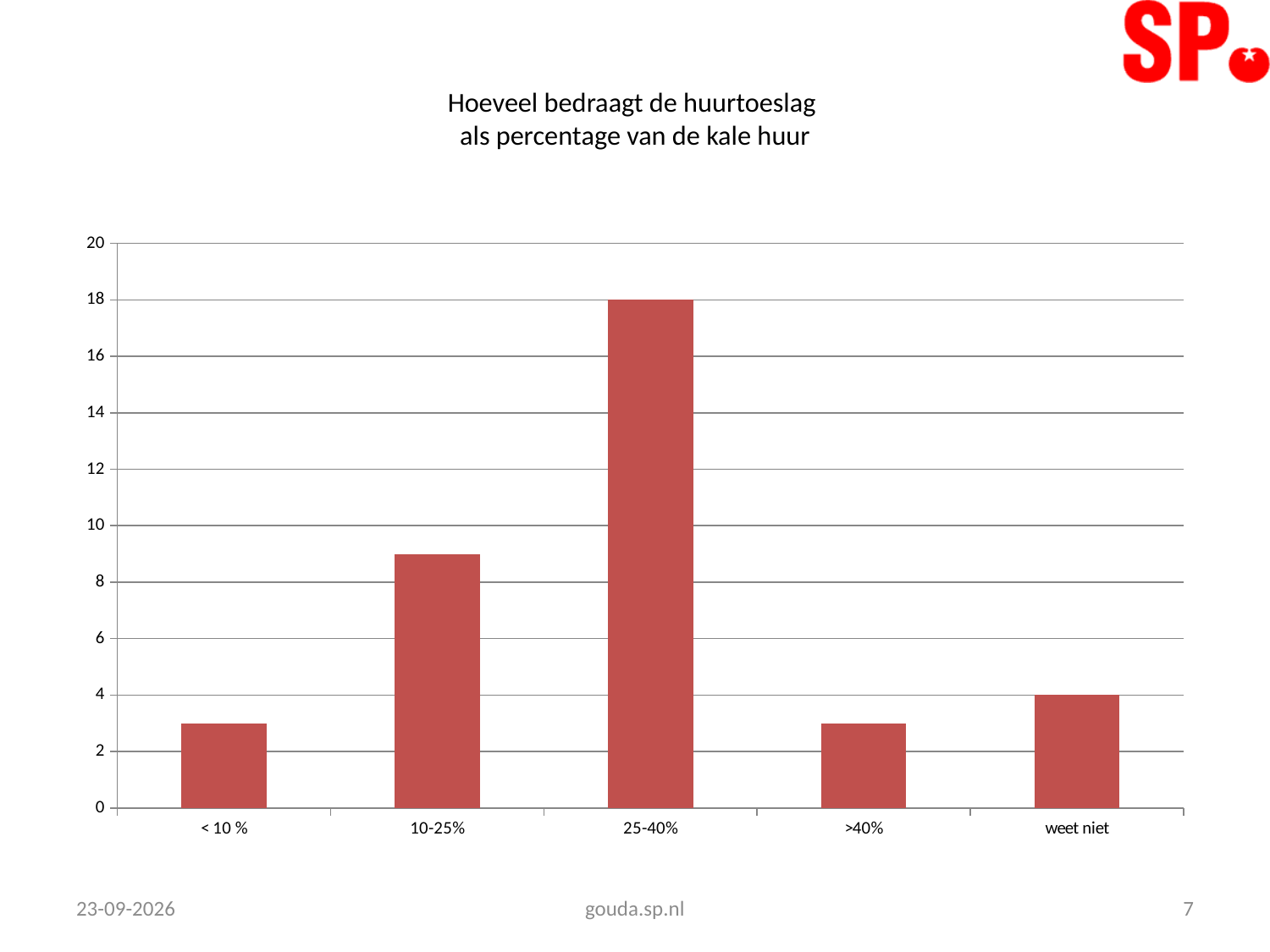
What kind of chart is shown on the slide? bar chart What is the title of the chart? Hoeveel bedraagt de huurtoeslag als percentage van de kale huur Is the value for 10-25% greater or less than 10? less Is the value for 10-25% greater or less than 8? greater What is the value for the 25-40% category? 18 What is the value for the 'weet niet' category? 4 Is the value for < 10 % greater or less than 4? less How many categories are shown on the x axis? 5 Which is larger, the value for 10-25% or the value for 'weet niet'? 10-25% Which category has the highest value? 25-40% What is the difference between the values for 25-40% and 'weet niet'? 14